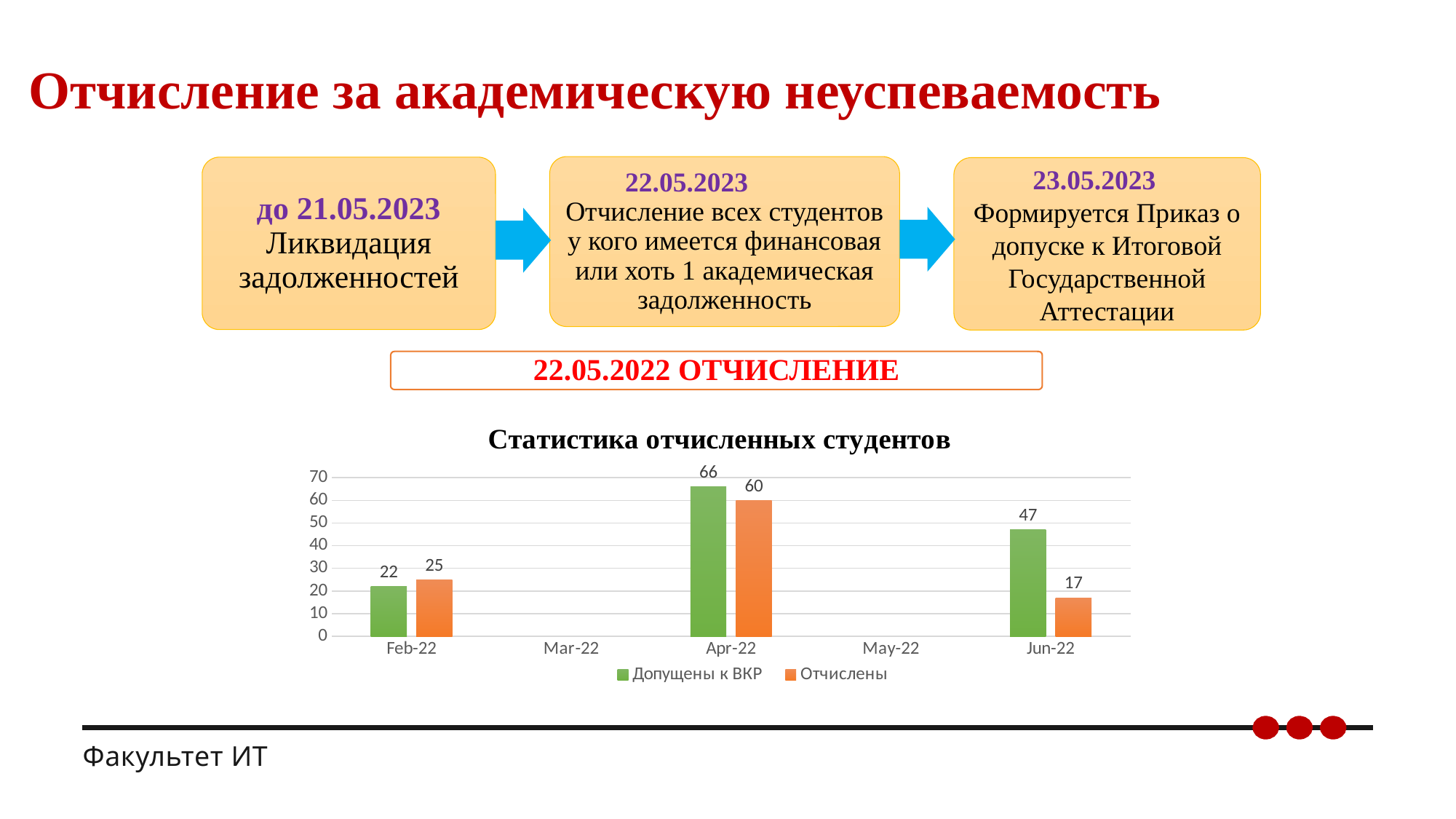
What is the difference between Допущены к ВКР and Отчислены in Apr-22? 6 Which month has the highest value for Отчислены? Apr-22 What is the value for Допущены к ВКР in Apr-22? 66 What is the value for Отчислены in Jun-22? 17 How many series does the legend list? 2 What is the title of the chart? Статистика отчисленных студентов What is the difference between Допущены к ВКР and Отчислены in Jun-22? 30 In Feb-22, which is larger: Допущены к ВКР or Отчислены? Отчислены How many month categories are shown on the x axis? 5 What is the value for Отчислены in Feb-22? 25 Which month with plotted bars has the lowest value for Допущены к ВКР? Feb-22 What kind of chart is shown on the slide? Bar chart